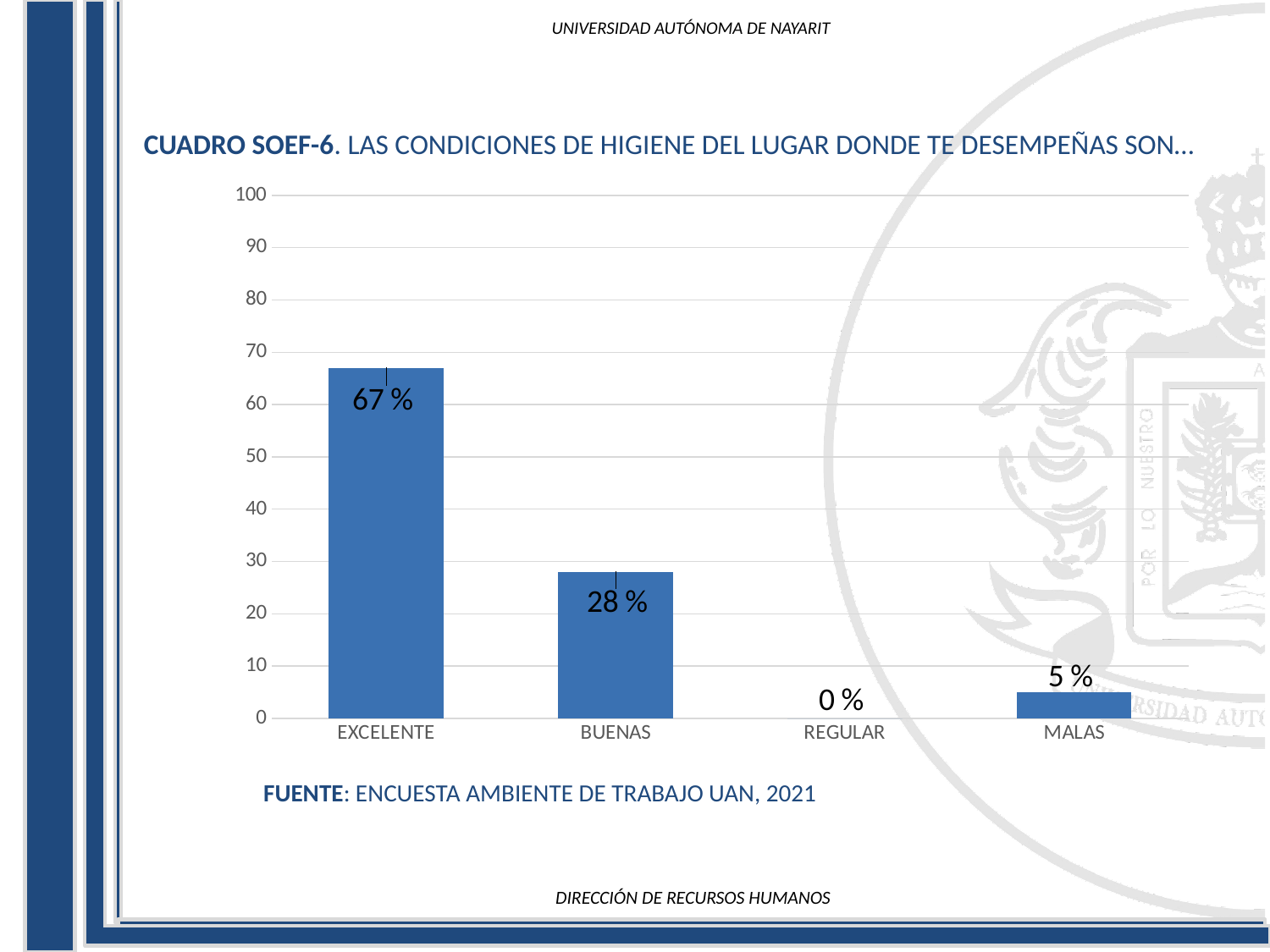
What is the value for BUENAS? 28 % Which is larger, the value for BUENAS or the value for MALAS? BUENAS How many categories are shown on the x axis? 4 What is the value for MALAS? 5 % What is the difference between the values for EXCELENTE and BUENAS? 39 % What is the value for REGULAR? 0 % What is the value for EXCELENTE? 67 % What kind of chart is shown on the slide? bar chart What is the source cited below the chart? ENCUESTA AMBIENTE DE TRABAJO UAN, 2021 Is the value for EXCELENTE greater or less than 60? greater Which category has the highest value? EXCELENTE Which category has the lowest value? REGULAR